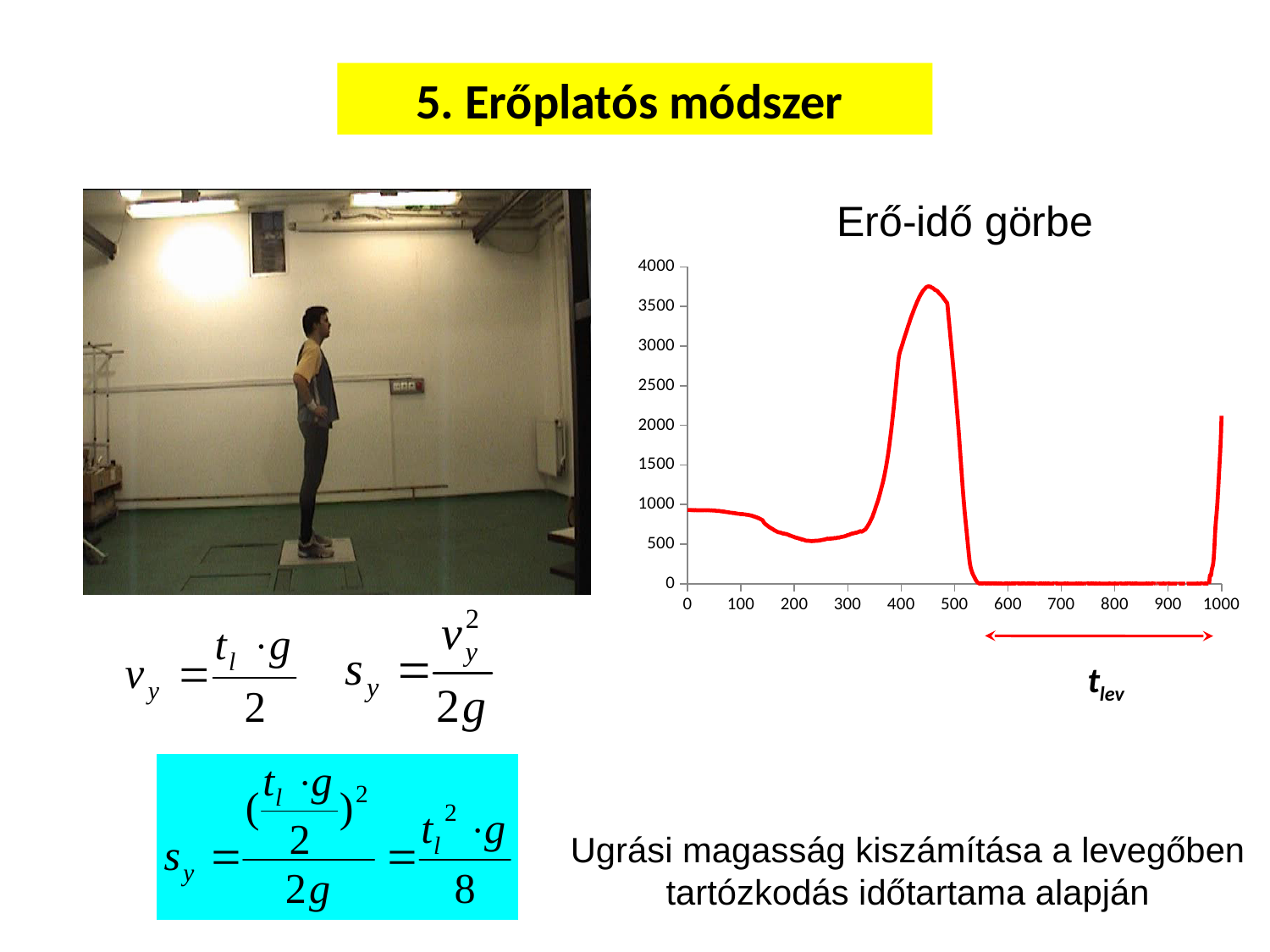
What is the title of the chart on the slide? Erő-idő görbe In the "Erő-idő görbe" chart, is the value at x = 450 greater or less than 3000? greater In the "Erő-idő görbe" chart, is the value at x = 200 greater or less than 1000? less What colour is the line plotted in the "Erő-idő görbe" chart? red In the "Erő-idő görbe" chart, is the value at x = 450 larger or smaller than the value at x = 1000? larger What kind of chart is the "Erő-idő görbe" chart? line chart In the "Erő-idő görbe" chart, is the value at x = 700 greater or less than 500? less In the "Erő-idő görbe" chart, does the line rise or fall between x = 300 and x = 450? rise In the "Erő-idő görbe" chart, does the line rise or fall between x = 500 and x = 550? fall What is the highest tick value shown on the y axis of the "Erő-idő görbe" chart? 4000